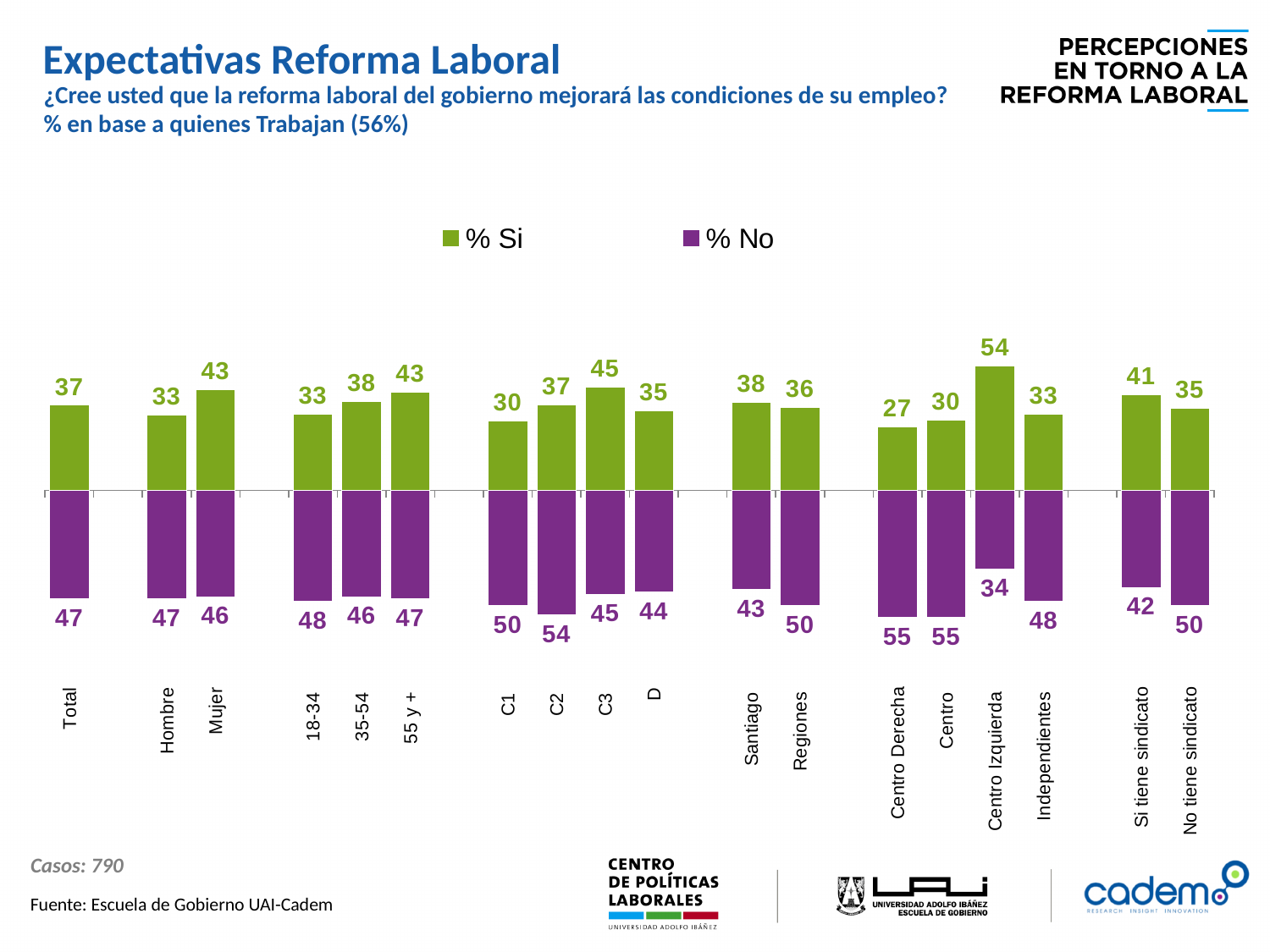
Which is larger for Mujer, the % Si value or the % No value? % No What is the % Si value for C3? 45 What is the % No value for Centro Izquierda? 34 What kind of chart is shown on the slide? Bar chart What is the difference between the % No and % Si values for Centro Derecha? 28 Which colour represents the % Si series in the legend? Green Which category has the highest % Si value? Centro Izquierda How many categories are shown on the x axis? 18 Which category has the lowest % Si value? Centro Derecha How many series does the legend list? 2 What is the % Si value for Total? 37 What is the % No value for C2? 54